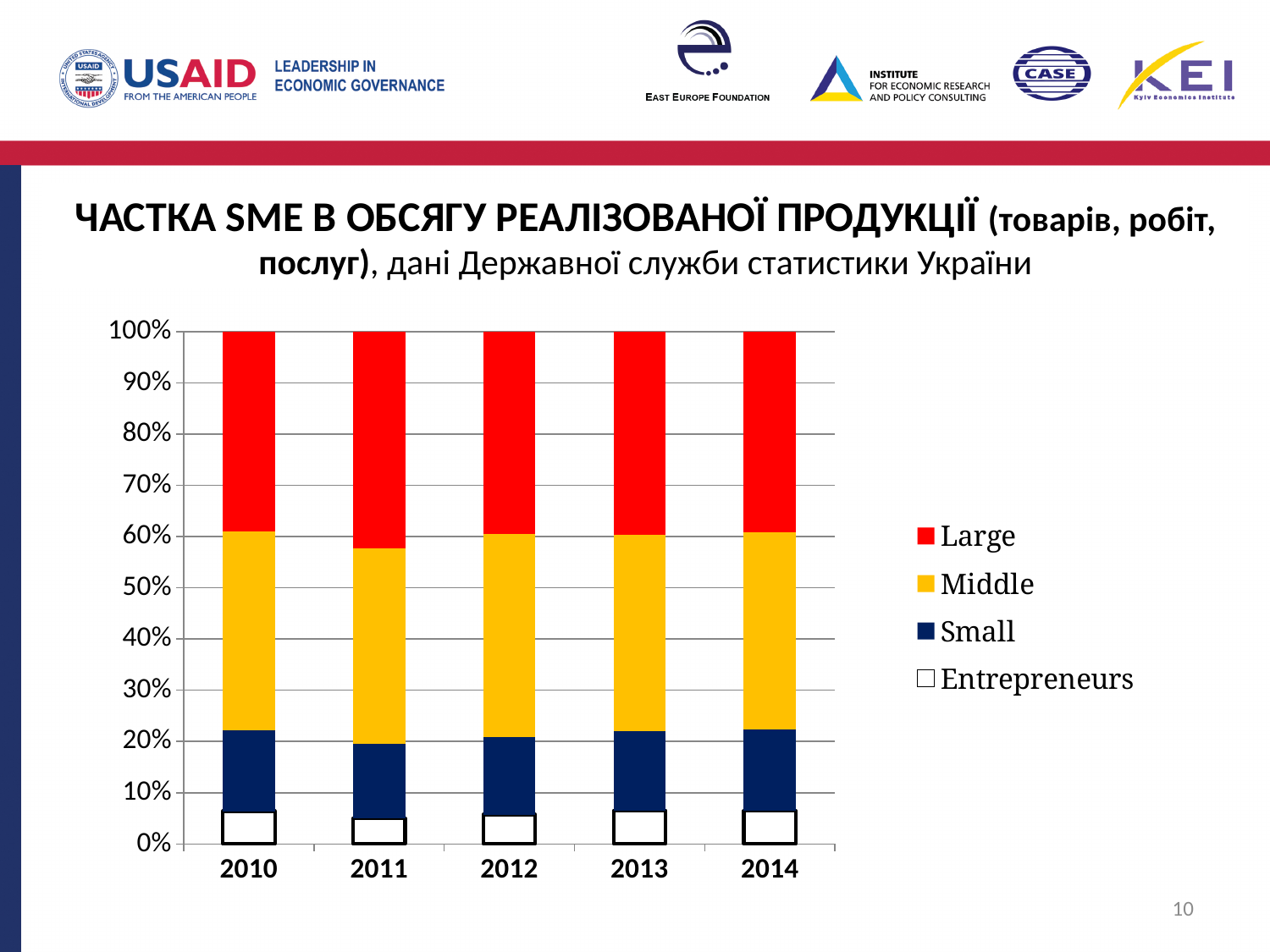
Which series is shown in white (unfilled) in the chart? Entrepreneurs How many years are shown on the x axis of the chart? 5 Is the Large segment bigger in 2011 or in 2010? 2011 Is the top of the Entrepreneurs segment for 2010 greater or less than 10%? less How many series does the chart legend list? 4 What kind of chart is shown on the slide? Stacked bar chart Which series is shown in red in the chart? Large Is the top of the Small segment (cumulative Entrepreneurs plus Small) for 2014 greater or less than 20%? greater Is the top of the Middle segment (cumulative share of SMEs) for 2011 greater or less than 60%? less Which year has the largest Large segment in the chart? 2011 What is the total height of the stacked bar for 2010? 100%